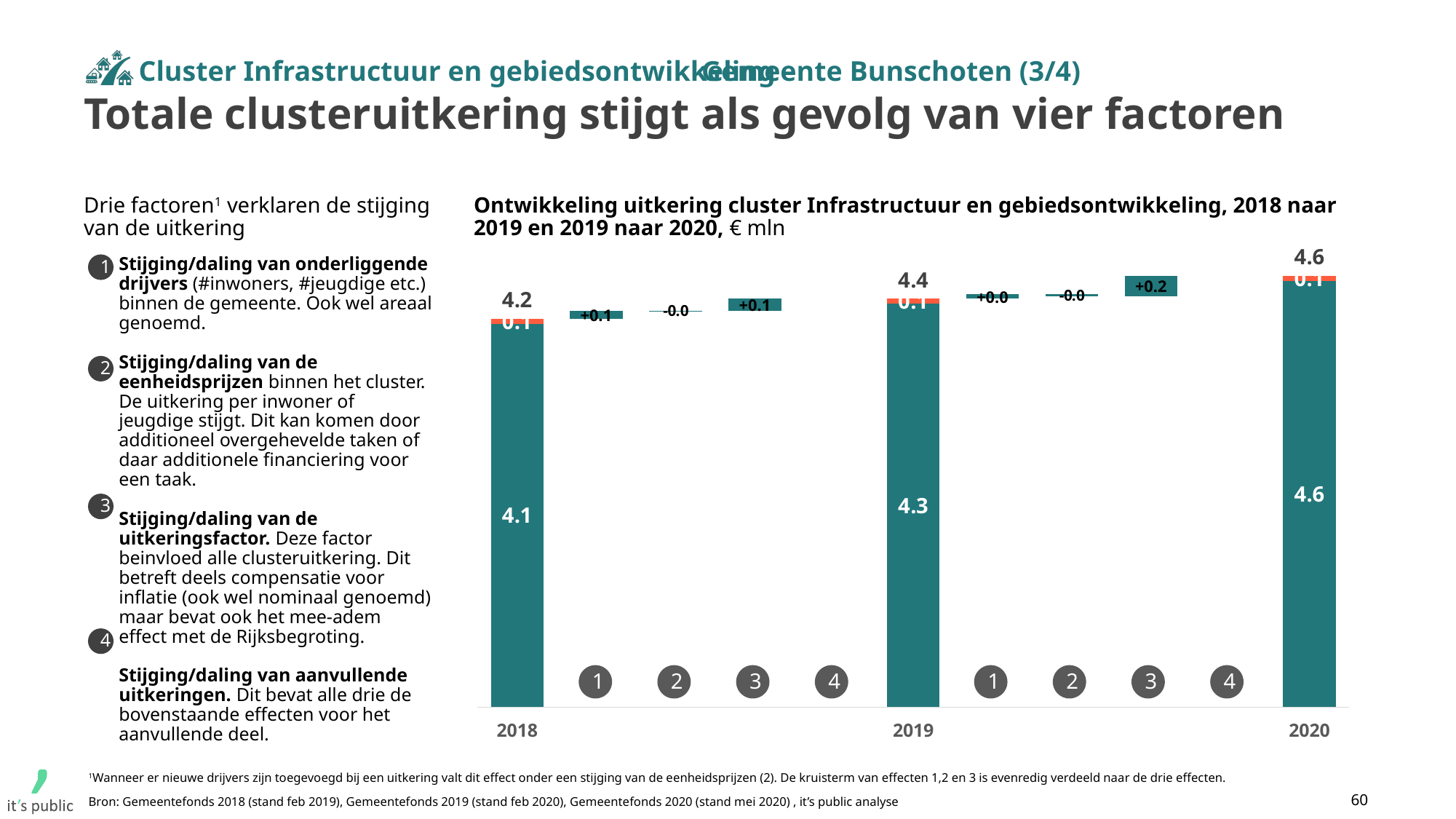
What is the total uitkering shown for 2019? 4.4 What is the value of factor 3 in the change from 2019 to 2020? +0.2 What is the difference between the 2020 total and the 2018 total? 0.4 What is the total uitkering shown for 2018? 4.2 What is the total uitkering shown for 2020? 4.6 Do the yearly totals rise or fall from 2018 to 2020? rise Which year has the highest total uitkering? 2020 What is the value of the large teal segment of the 2019 bar? 4.3 Which year has the lowest total uitkering? 2018 What is the value of factor 1 in the change from 2018 to 2019? +0.1 Is the total uitkering for 2019 larger or smaller than for 2018? larger In what unit are the values in the chart expressed? € mln